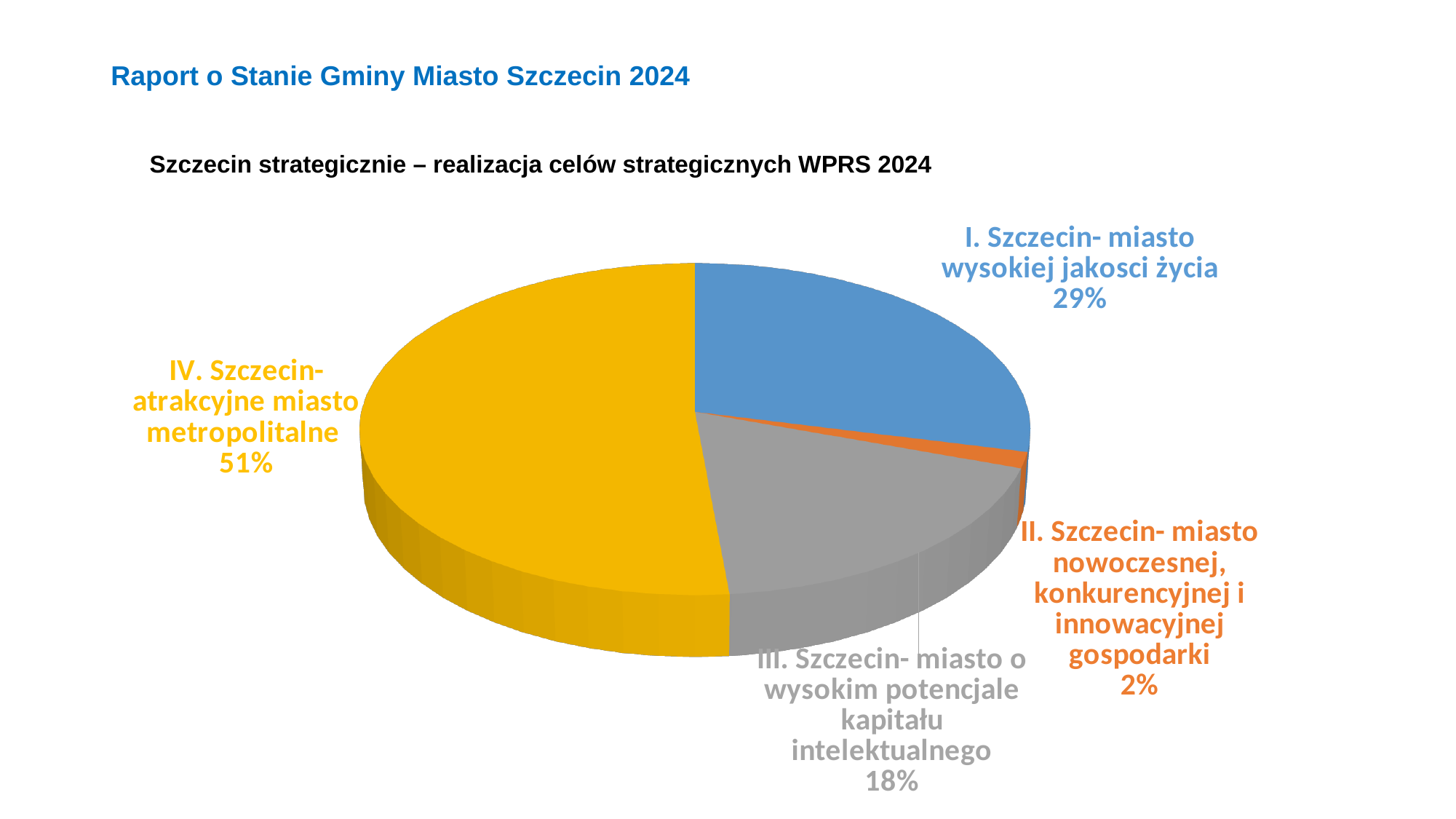
What share of the pie does 'IV. Szczecin- atrakcyjne miasto metropolitalne' have? 51% What colour is the slice for 'IV. Szczecin- atrakcyjne miasto metropolitalne'? Yellow What share of the pie does 'III. Szczecin- miasto o wysokim potencjale kapitału intelektualnego' have? 18% Which category has the smallest slice of the pie? II. Szczecin- miasto nowoczesnej, konkurencyjnej i innowacyjnej gospodarki What is the difference in percentage points between the share for 'IV. Szczecin- atrakcyjne miasto metropolitalne' and 'I. Szczecin- miasto wysokiej jakosci życia'? 22 percentage points How many slices does the pie chart have? 4 What share of the pie does 'I. Szczecin- miasto wysokiej jakosci życia' have? 29% What kind of chart is shown on the slide? Pie chart What is the difference in percentage points between the share for 'I. Szczecin- miasto wysokiej jakosci życia' and 'III. Szczecin- miasto o wysokim potencjale kapitału intelektualnego'? 11 percentage points Which has a larger share: 'I. Szczecin- miasto wysokiej jakosci życia' or 'III. Szczecin- miasto o wysokim potencjale kapitału intelektualnego'? I. Szczecin- miasto wysokiej jakosci życia Which category has the largest slice of the pie? IV. Szczecin- atrakcyjne miasto metropolitalne